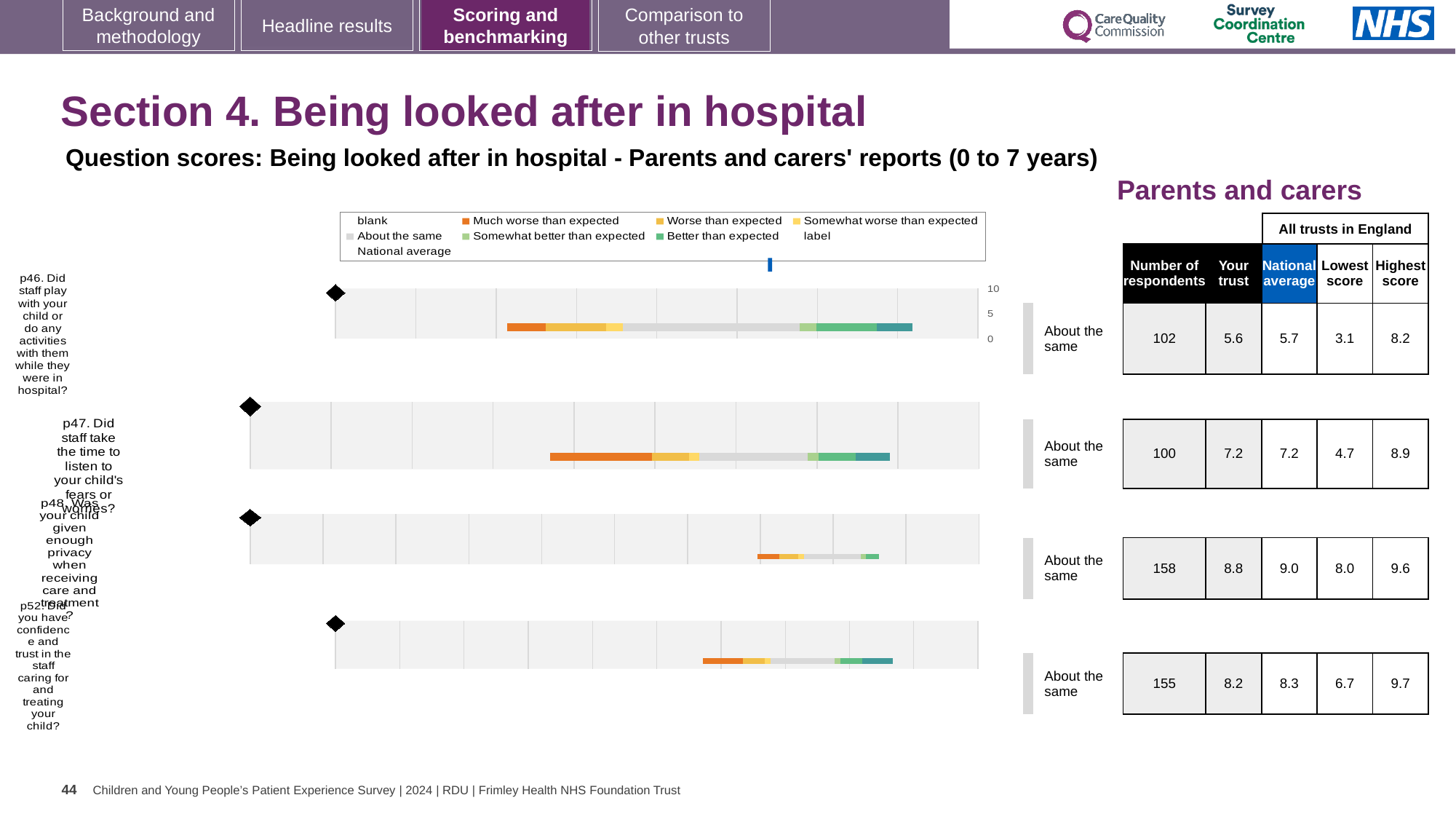
What is the 'Your trust' score for p46 (Did staff play with your child or do any activities with them while they were in hospital?)? 5.6 How many questions (p-numbered items) are plotted on the slide? 4 What benchmark category is shown next to the chart for p46? About the same Which question has the highest 'Your trust' score? p48 What colour does the legend use for 'Much worse than expected'? Orange What kind of chart is used to show the question scores on this slide? bar chart What is the difference between the national average and the 'Your trust' score for p46? 0.1 How many respondents answered p48? 158 What is the difference between the highest score and the lowest score across all trusts in England for p47? 4.2 Which question has the lowest 'Your trust' score? p46 For p52, which is larger: the 'Your trust' score or the national average? National average What is the national average score for p48 (Was your child given enough privacy when receiving care and treatment?)? 9.0